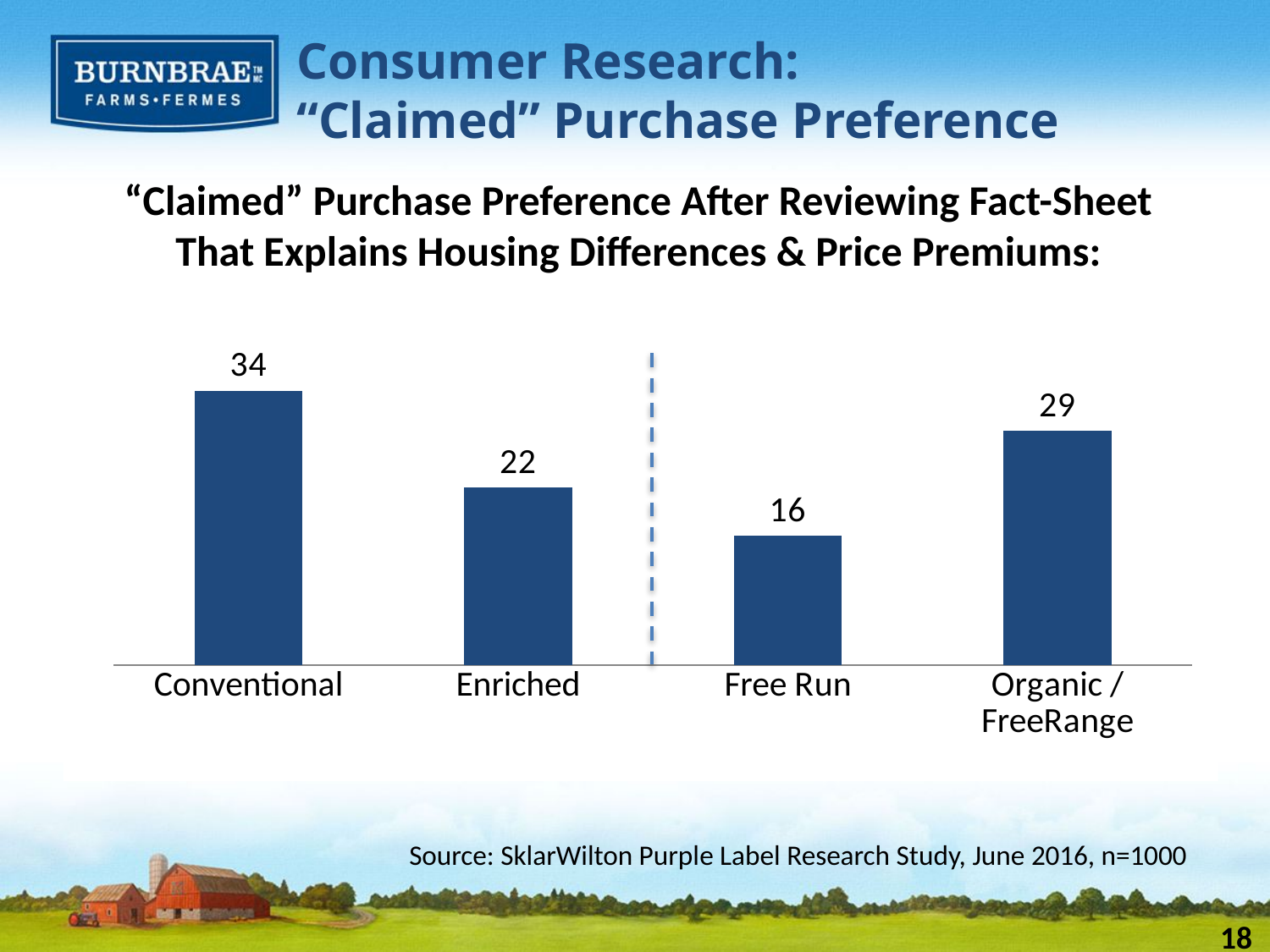
What is the value for Conventional? 34 Which category has the lowest value? Free Run What is the value for Organic / FreeRange? 29 What is the source cited for the chart data? SklarWilton Purple Label Research Study, June 2016, n=1000 What is the value for Free Run? 16 Which is larger, the value for Enriched or the value for Organic / FreeRange? Organic / FreeRange What is the value for Enriched? 22 Which category has the highest value? Conventional What is the difference between the values for Conventional and Free Run? 18 What is the difference between the values for Organic / FreeRange and Enriched? 7 What kind of chart is shown on the slide? Bar chart How many categories are shown in the chart? 4